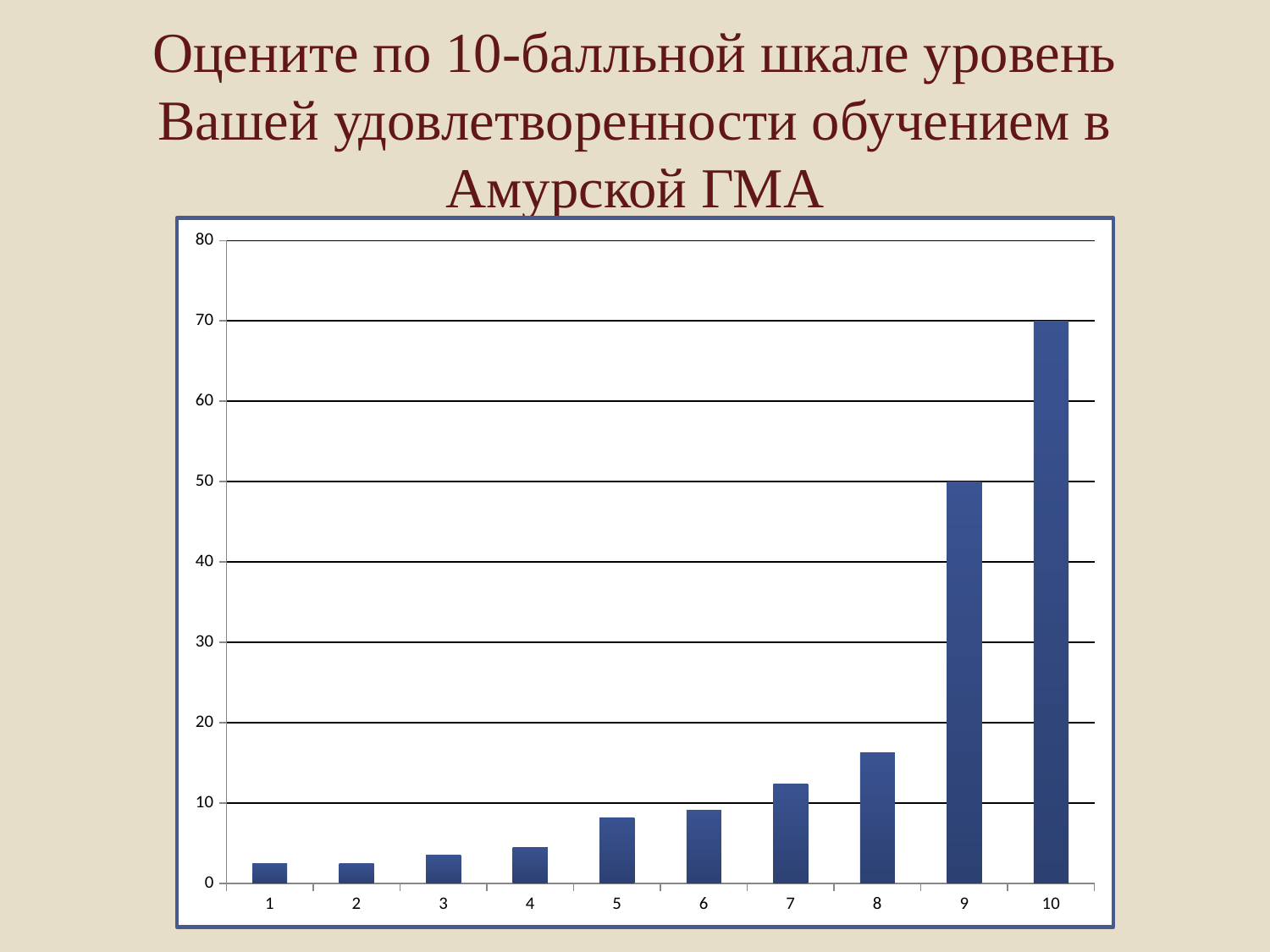
Which is larger, the value for category 8 or the value for category 9? 9 What is the difference between the values for category 10 and category 9? 20 Is the value for category 7 greater or less than 10? greater Which category has the highest bar in the chart? 10 Is the value for category 5 greater or less than 10? less What is the value for category 9? 50 What is the highest value shown on the vertical axis of the chart? 80 How many categories are shown on the x axis of the chart? 10 What is the value for category 10? 70 Do the values generally rise or fall from category 1 to category 10? rise What type of chart is shown on the slide? bar chart Is the value for category 8 greater or less than 20? less